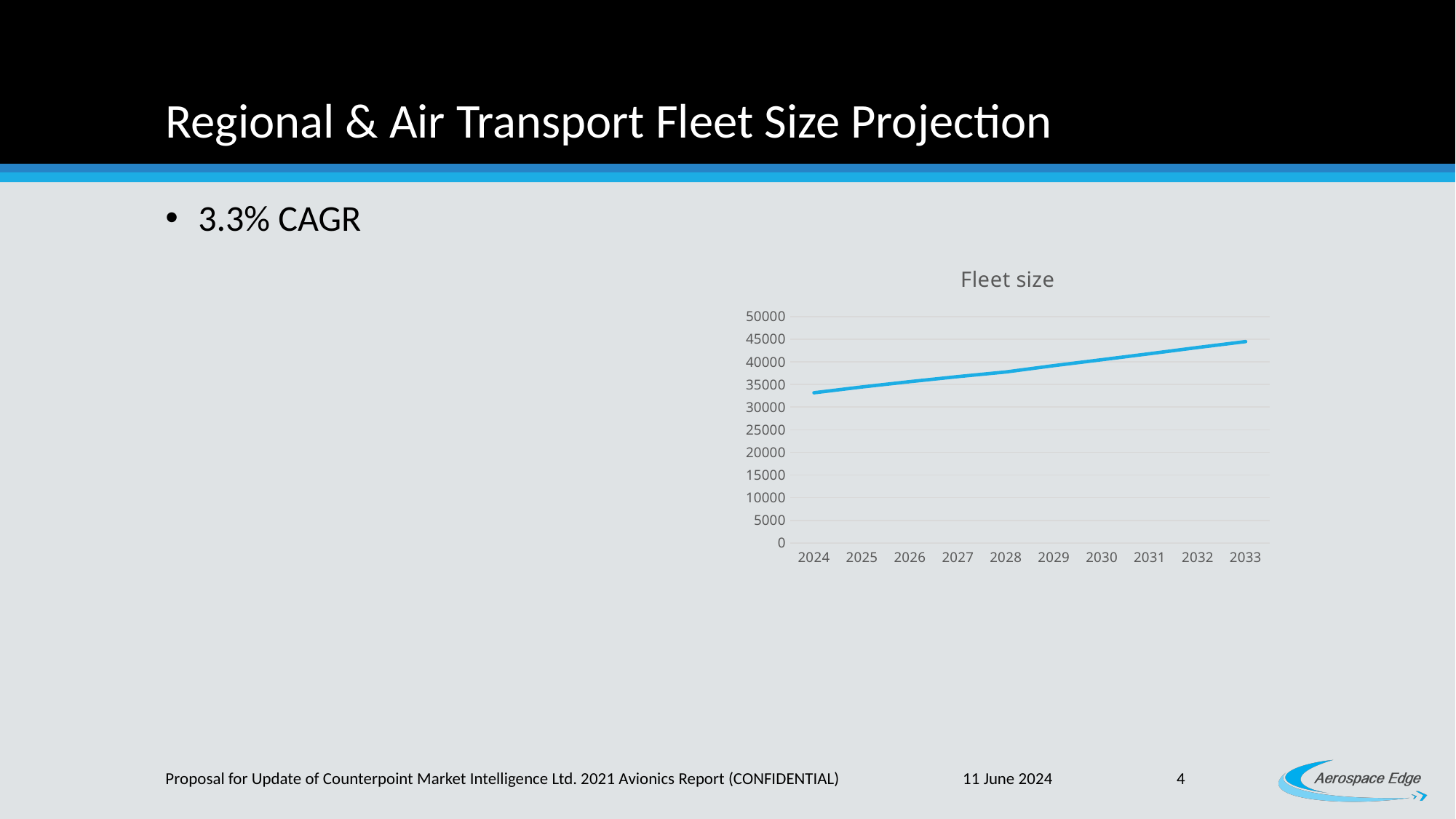
Is the fleet size for 2024 greater or less than 35000? less Is the fleet size for 2033 greater or less than 40000? greater What kind of chart is shown on the slide? line chart Does the fleet size rise or fall from 2024 to 2033? rise Which year has the larger fleet size, 2025 or 2032? 2032 What is the title of the chart? Fleet size Which year has the lowest fleet size? 2024 What is the first year shown on the x axis of the chart? 2024 Is the fleet size for 2028 greater or less than 35000? greater Which year has the highest fleet size? 2033 How many years are plotted along the x axis of the chart? 10